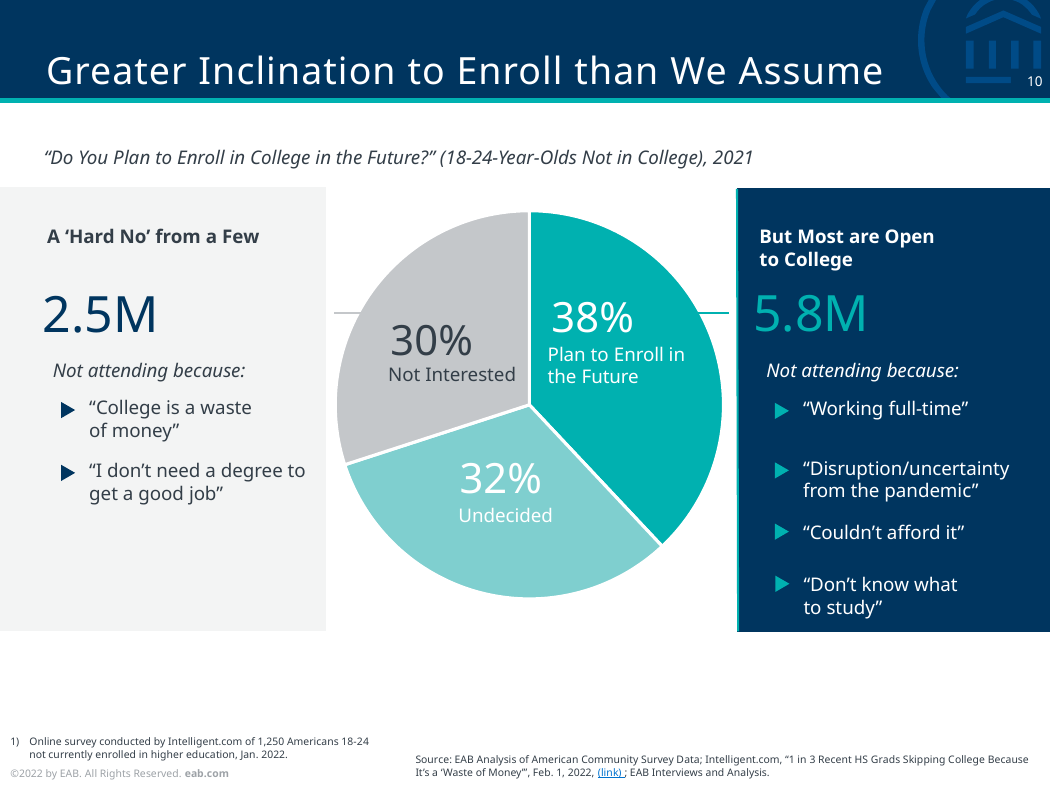
Which is larger: the 'Undecided' share or the 'Not Interested' share? Undecided Which slice of the pie chart is colored grey? Not Interested What is the combined percentage of respondents who are undecided or plan to enroll? 70% Which slice of the pie chart is the largest? Plan to Enroll in the Future What percentage of respondents plan to enroll in the future? 38% How many slices does the pie chart have? 3 What percentage of respondents are not interested? 30% Which slice of the pie chart is the smallest? Not Interested What question does the pie chart summarize responses to? "Do You Plan to Enroll in College in the Future?" What is the difference in percentage points between the 'Plan to Enroll in the Future' slice and the 'Not Interested' slice? 8 What type of chart is shown on the slide? Pie chart What percentage of respondents are undecided? 32%